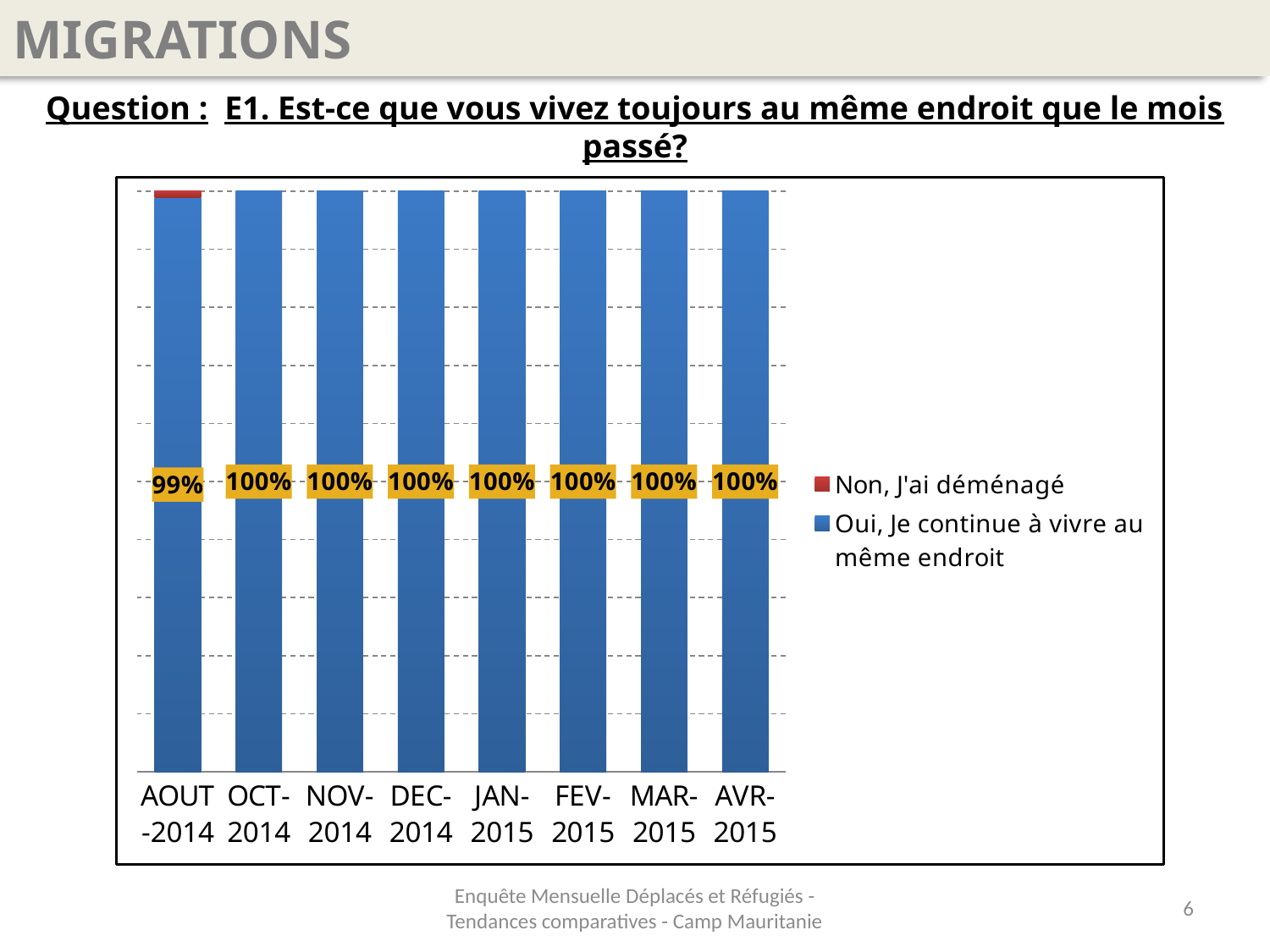
What is the first month shown on the x axis of the chart? AOUT-2014 What is the value for "Oui, Je continue à vivre au même endroit" in JAN-2015? 100% How many series does the chart legend list? 2 What kind of chart is shown on the slide? bar chart Which month is the only one where the "Non, J'ai déménagé" series is visible in the chart? AOUT-2014 What colour represents the series "Non, J'ai déménagé" in the chart? red Which month has the lowest value for "Oui, Je continue à vivre au même endroit"? AOUT-2014 What is the difference between the "Oui, Je continue à vivre au même endroit" values for OCT-2014 and AOUT-2014? 1% Which is larger, the "Oui, Je continue à vivre au même endroit" value for AOUT-2014 or for DEC-2014? DEC-2014 How many months are shown on the x axis of the chart? 8 What is the value for "Oui, Je continue à vivre au même endroit" in AVR-2015? 100% What is the value for "Oui, Je continue à vivre au même endroit" in AOUT-2014? 99%